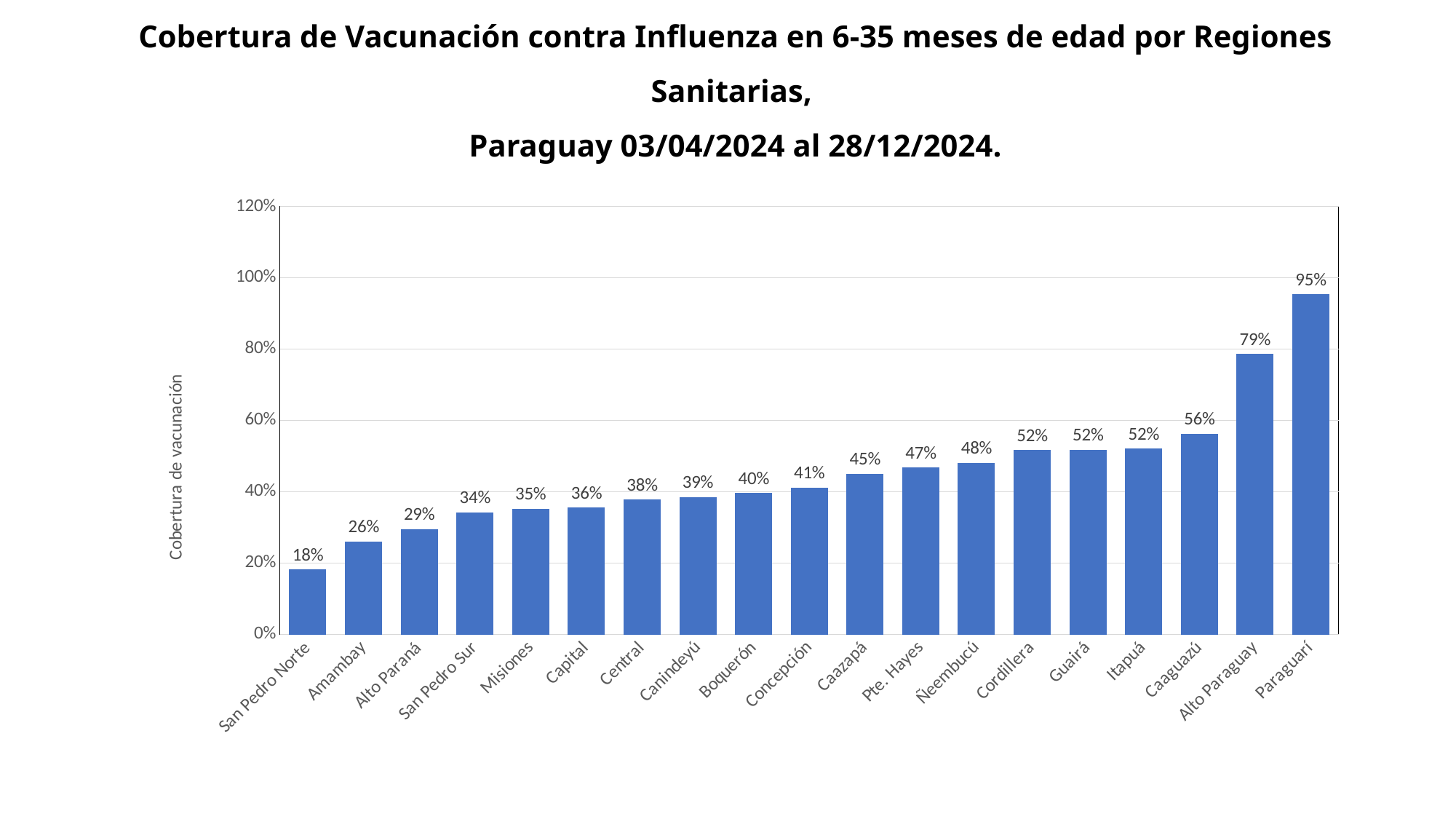
Which has higher coverage, Amambay or Misiones? Misiones What is the vaccination coverage for Paraguarí? 95% Which region has the lowest vaccination coverage? San Pedro Norte What is the vaccination coverage for Central? 38% Which region has the highest vaccination coverage? Paraguarí What type of chart is shown? Bar chart Do the values rise or fall from left to right along the x axis? Rise What is the vaccination coverage for Alto Paraguay? 79% What is the difference in coverage between Paraguarí and San Pedro Norte? 77% What is the difference in coverage between Caaguazú and Concepción? 15% How many regions are shown on the chart? 19 What is the label of the vertical axis? Cobertura de vacunación